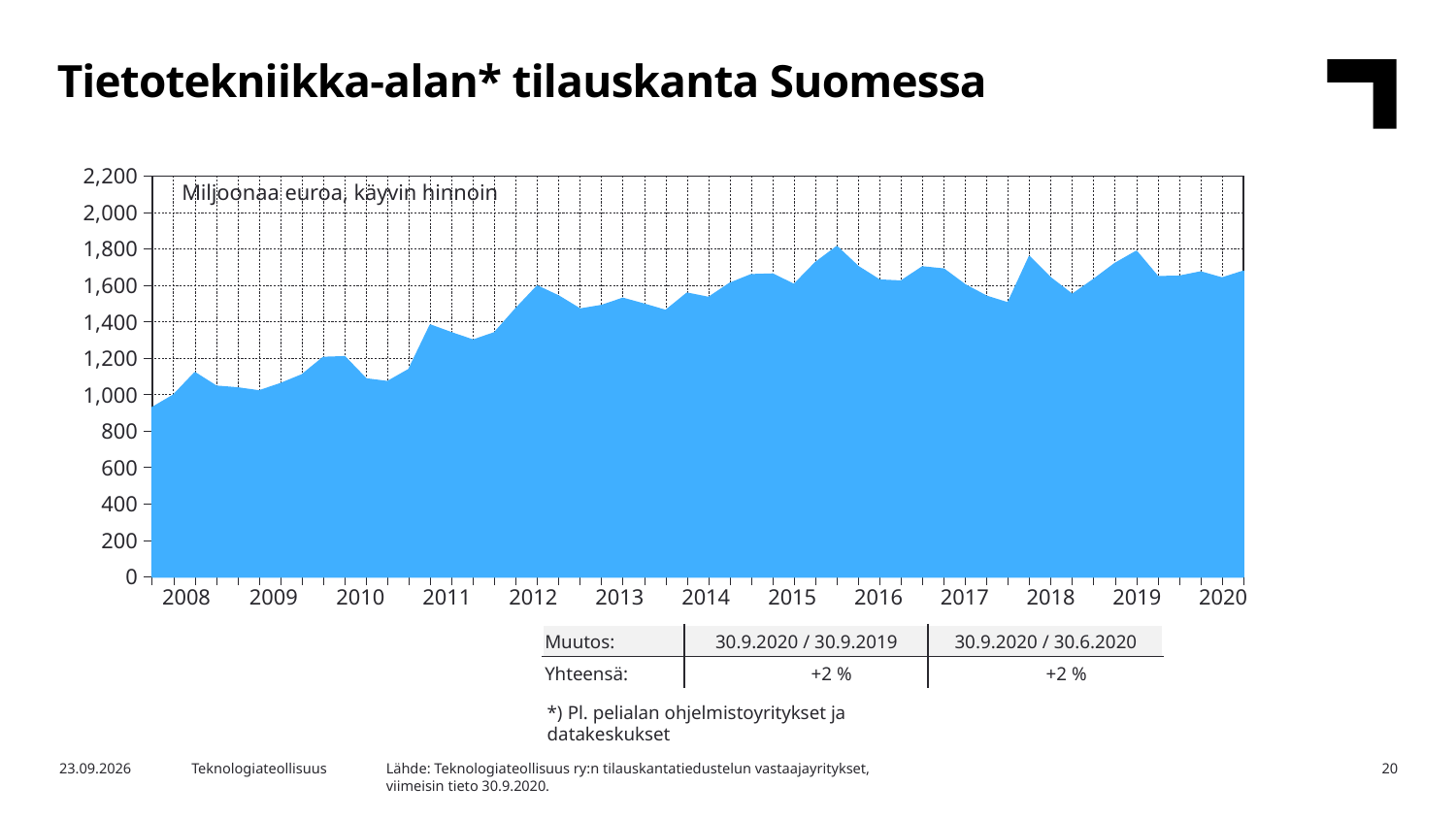
Is the value at the start of 2010 greater or less than 1,400? less According to the table below the chart, what is the change (Muutos) for 30.9.2020 / 30.9.2019? +2 % What kind of chart is shown on the slide? Area chart What is the first year labelled on the horizontal axis? 2008 What unit is stated inside the chart area? Miljoonaa euroa, käyvin hinnoin What is the highest value shown on the vertical axis? 2,200 Is the peak value reached around 2015–2016 greater or less than 1,600? greater Is the value at the start of 2008 greater or less than 1,000? less What is the title of the chart on the slide? Tietotekniikka-alan* tilauskanta Suomessa Overall, do the values rise or fall from 2008 to 2020? Rise What is the last year labelled on the horizontal axis? 2020 How many year labels are shown on the horizontal axis? 13